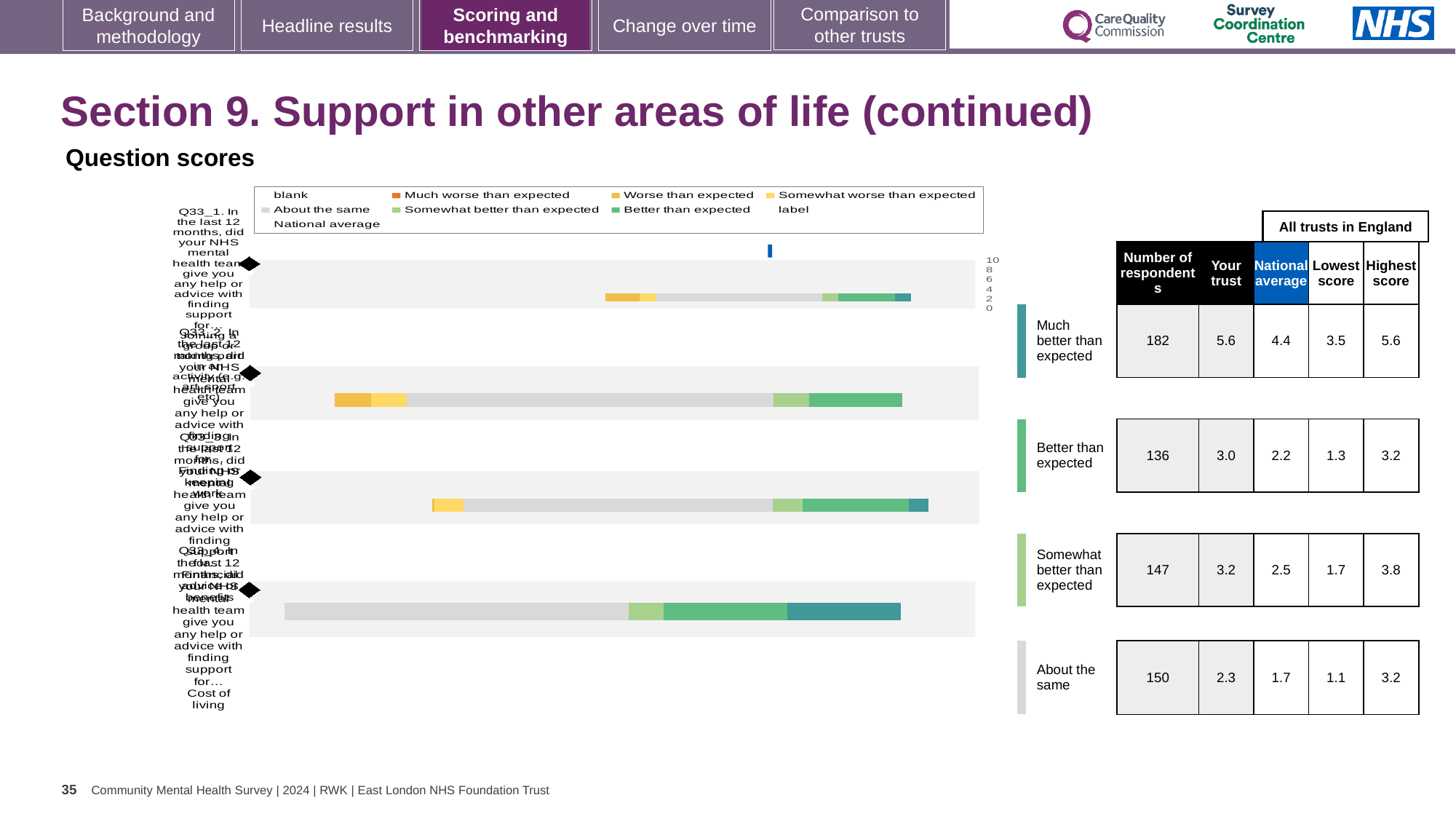
Which question's bar contains no orange or yellow 'worse than expected' segments? Q33_4 In the table beside the chart, which question has the lowest 'Your trust' score? Q33_4 In the table beside the chart, is the 'Your trust' score for Q33_2 larger or smaller than the national average? larger In the table beside the chart, which question has the highest 'Your trust' score? Q33_1 What colour does the legend use for 'Better than expected'? green In the table beside the chart, what is the number of respondents for Q33_1? 182 What kind of chart is shown on the slide? bar chart How many question bars are plotted in the chart? 4 In the table beside the chart, what is the national average for Q33_4? 1.7 In the table beside the chart, what is the 'Your trust' score for Q33_3? 3.2 In the table beside the chart, what is the difference between the 'Your trust' score and the national average for Q33_1? 1.2 What colour does the legend use for 'About the same'? grey